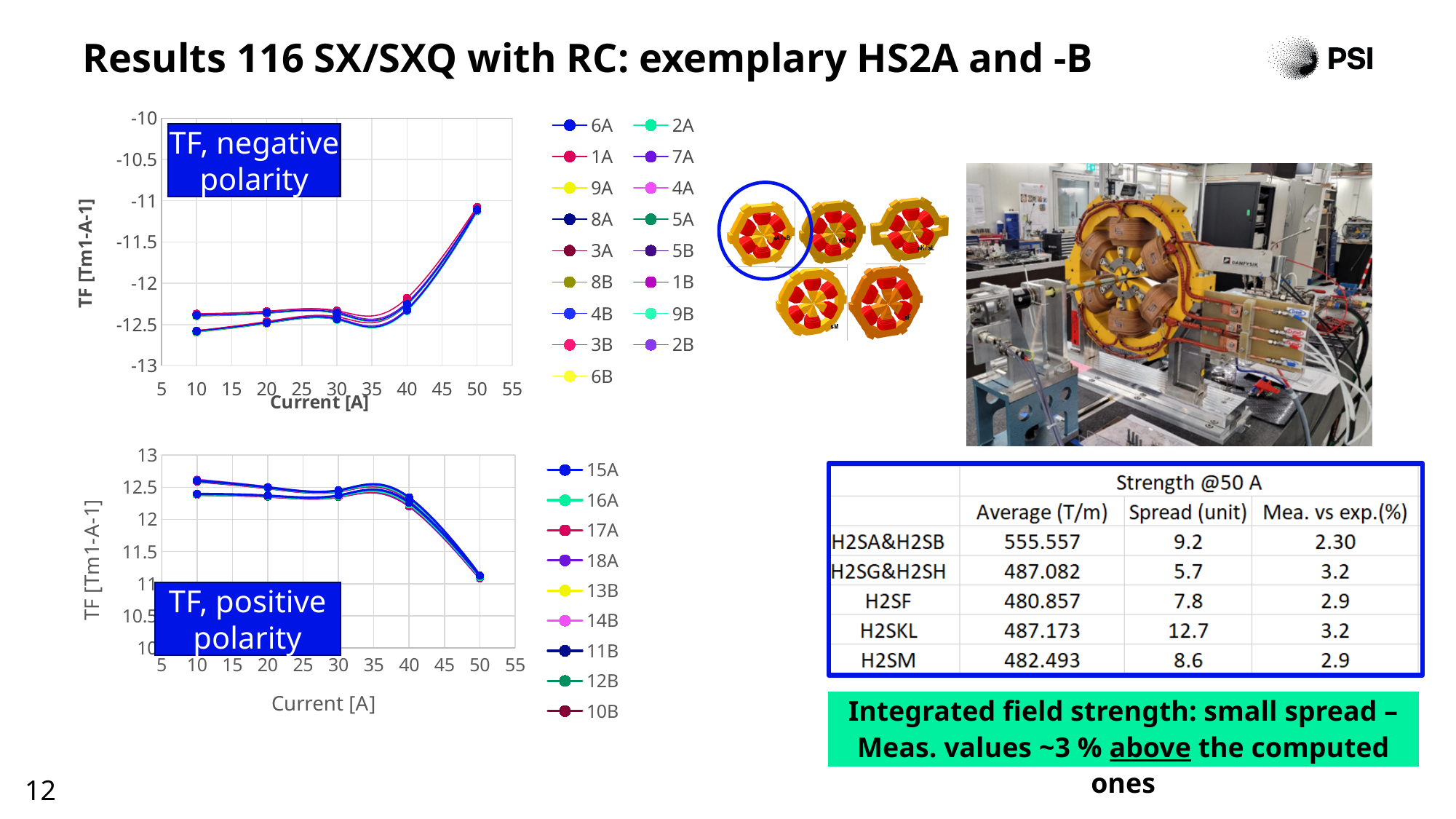
In the 'TF, negative polarity' chart, how many data points does each series have along the current axis? 9 In the 'TF, positive polarity' chart, is the TF value at 50 A greater or less than 11.5? less How many series does the legend of the 'TF, positive polarity' chart list? 9 How many series does the legend of the 'TF, negative polarity' chart list? 17 What kind of chart is the 'TF, negative polarity' chart? line chart In the 'TF, negative polarity' chart, do the TF values rise or fall as the current increases from 10 A to 50 A? rise In the 'TF, negative polarity' chart, is the TF value at 50 A greater or less than -11.5? greater In the 'TF, positive polarity' chart, is the TF value at 10 A greater or less than 12? greater In the 'TF, positive polarity' chart, do the TF values rise or fall as the current increases from 10 A to 50 A? fall In the 'TF, positive polarity' chart, which current has the larger TF value: 10 A or 50 A? 10 A What is the x-axis label of the 'TF, negative polarity' chart? Current [A]